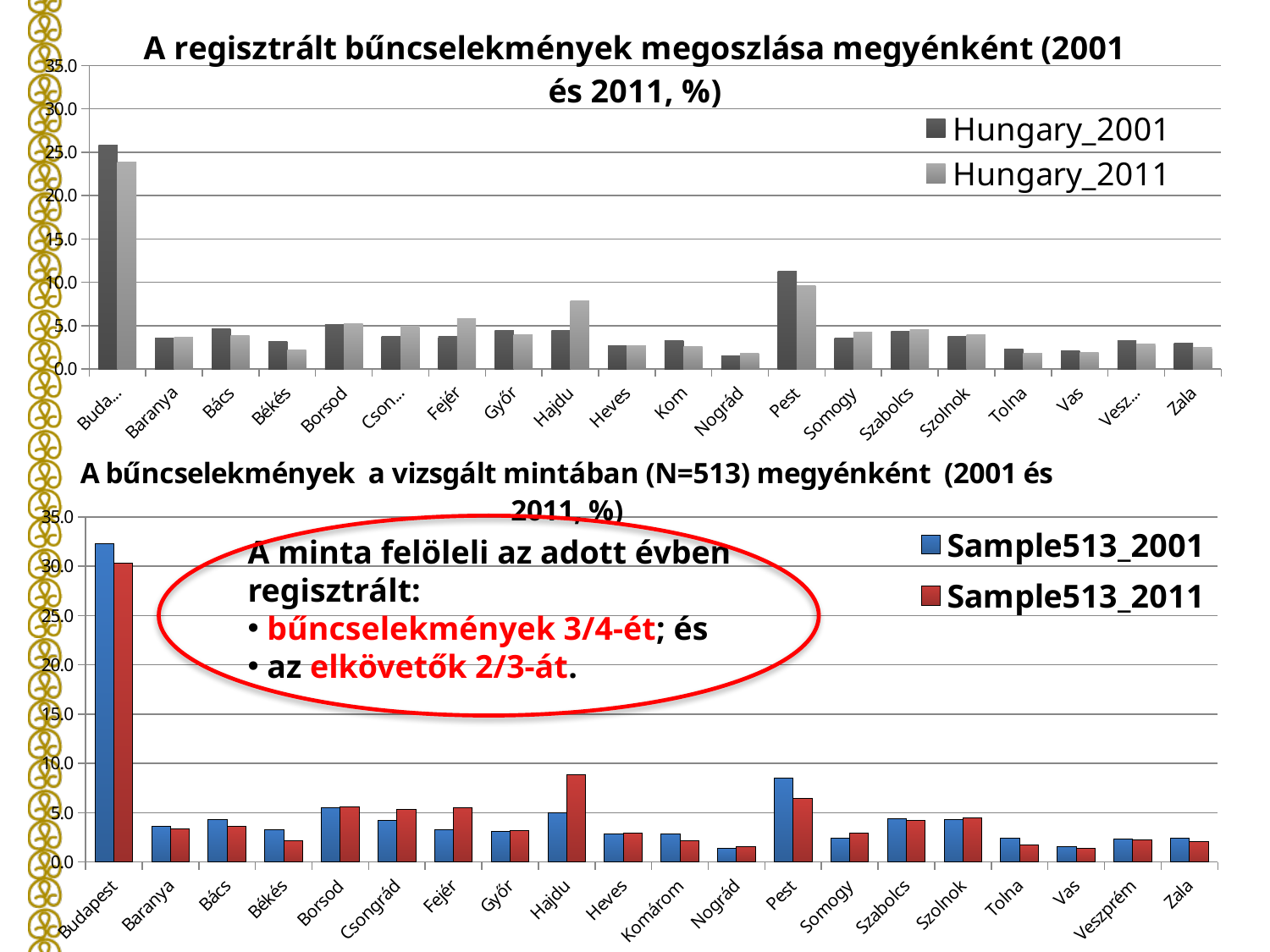
In the top chart, is the Hungary_2011 value for Hajdu greater or less than 5.0? greater In the top chart, is the Hungary_2001 value for Pest greater or less than 10.0? greater In the bottom chart, which county has the highest Sample513_2001 value? Budapest What are the two legend entries of the bottom chart? Sample513_2001 and Sample513_2011 In the bottom chart, which is larger for Pest: the Sample513_2001 value or the Sample513_2011 value? Sample513_2001 How many series does the legend of the top chart list? 2 In the top chart, which is larger for Hajdu: the Hungary_2001 value or the Hungary_2011 value? Hungary_2011 In the bottom chart, is the Sample513_2001 value for Budapest greater or less than 30.0? greater How many counties are shown on the x axis of the bottom chart? 20 What kind of chart is the top chart, 'A regisztrált bűncselekmények megoszlása megyénként'? bar chart In the bottom chart, which is larger for Hajdu: the Sample513_2001 value or the Sample513_2011 value? Sample513_2011